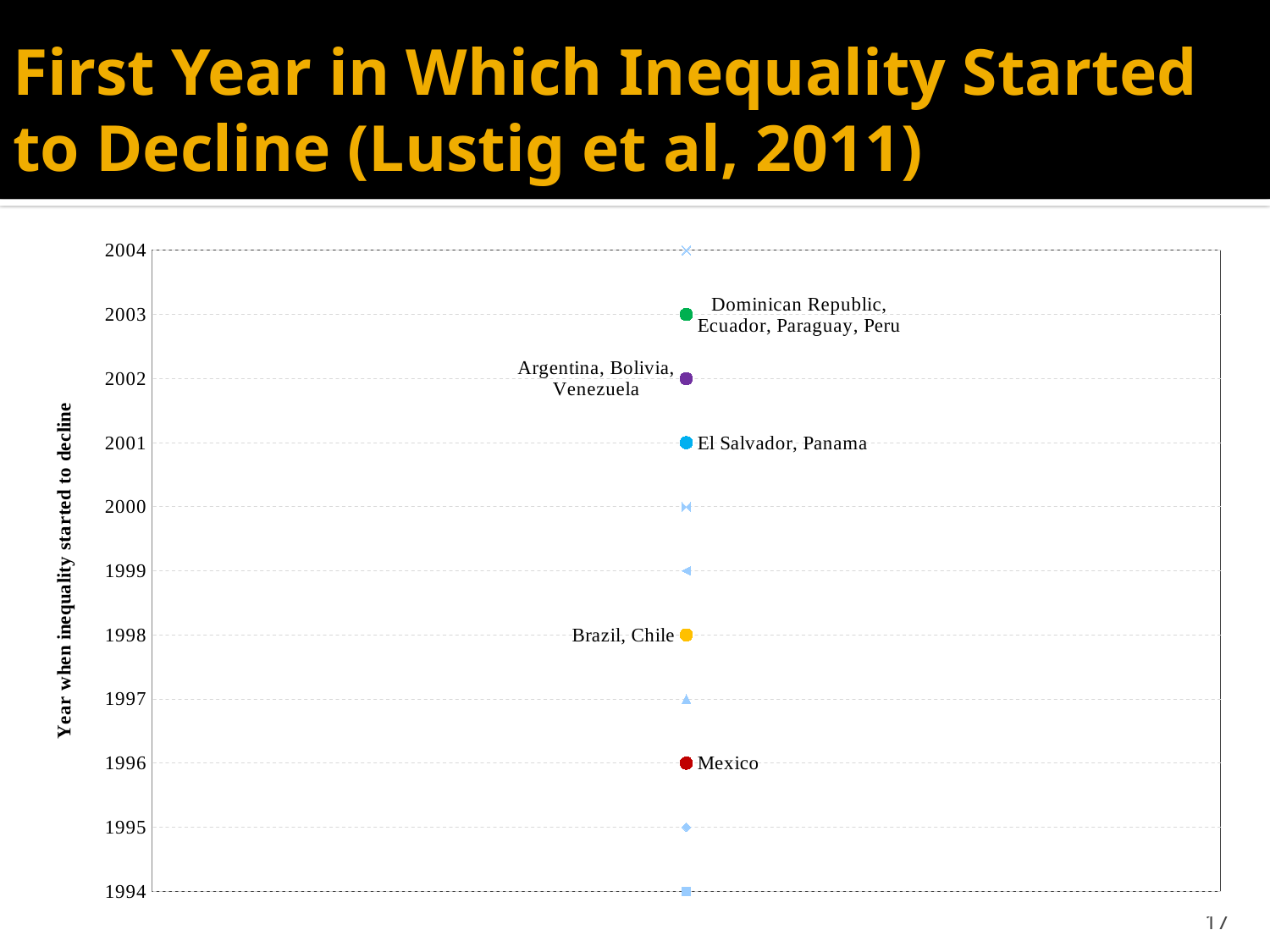
What is the label of the vertical axis of the chart? Year when inequality started to decline Did inequality start to decline earlier in Mexico or in El Salvador and Panama? Mexico How many years separate the start of inequality decline in El Salvador and Panama from that in the Dominican Republic, Ecuador, Paraguay and Peru? 2 In which year did inequality start to decline in El Salvador and Panama? 2001 How many years separate the start of inequality decline in Mexico from that in Brazil and Chile? 2 Which labelled country group has the earliest year in which inequality started to decline? Mexico What is the title of the chart on the slide? First Year in Which Inequality Started to Decline (Lustig et al, 2011) In which year did inequality start to decline in Mexico, according to the chart? 1996 Which labelled country group has the latest year in which inequality started to decline? Dominican Republic, Ecuador, Paraguay, Peru In which year did inequality start to decline in Argentina, Bolivia and Venezuela? 2002 In which year did inequality start to decline in the Dominican Republic, Ecuador, Paraguay and Peru? 2003 In which year did inequality start to decline in Brazil and Chile? 1998